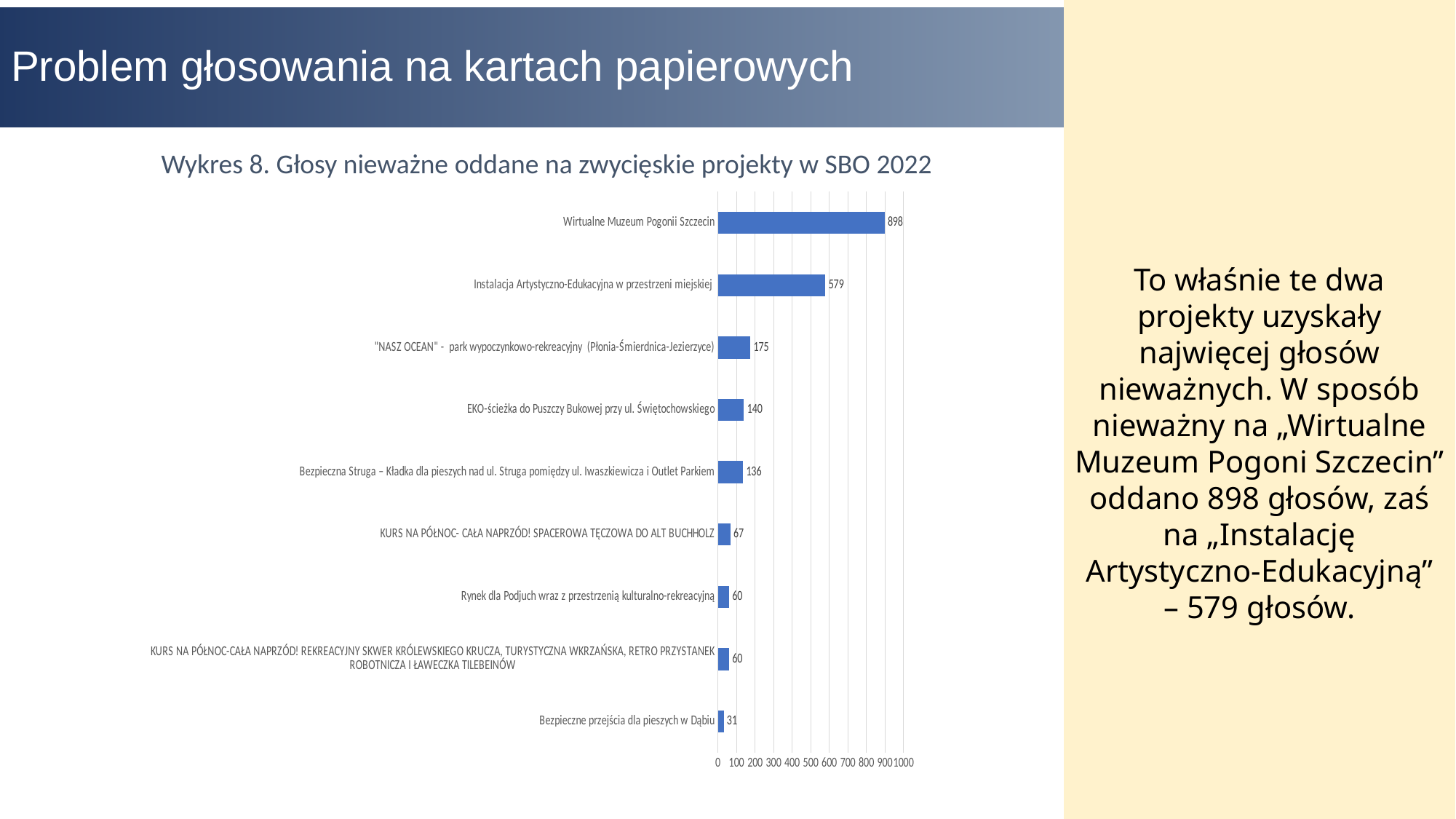
Which category has the lowest value? Bezpieczne przejścia dla pieszych w Dąbiu What is the title of the chart? Wykres 8. Głosy nieważne oddane na zwycięskie projekty w SBO 2022 Is the value for Instalacja Artystyczno-Edukacyjna w przestrzeni miejskiej greater or less than 500? greater Which is larger: the value for "NASZ OCEAN" - park wypoczynkowo-rekreacyjny (Płonia-Śmierdnica-Jezierzyce) or the value for EKO-ścieżka do Puszczy Bukowej przy ul. Świętochowskiego? "NASZ OCEAN" - park wypoczynkowo-rekreacyjny (Płonia-Śmierdnica-Jezierzyce) What is the value for Instalacja Artystyczno-Edukacyjna w przestrzeni miejskiej? 579 What kind of chart is shown on the slide? bar chart Which category has the highest value? Wirtualne Muzeum Pogonii Szczecin How many categories are shown in the chart? 9 What is the value for KURS NA PÓŁNOC- CAŁA NAPRZÓD! SPACEROWA TĘCZOWA DO ALT BUCHHOLZ? 67 What is the difference between the values for Wirtualne Muzeum Pogonii Szczecin and Instalacja Artystyczno-Edukacyjna w przestrzeni miejskiej? 319 What is the value for Wirtualne Muzeum Pogonii Szczecin? 898 What is the value for EKO-ścieżka do Puszczy Bukowej przy ul. Świętochowskiego? 140